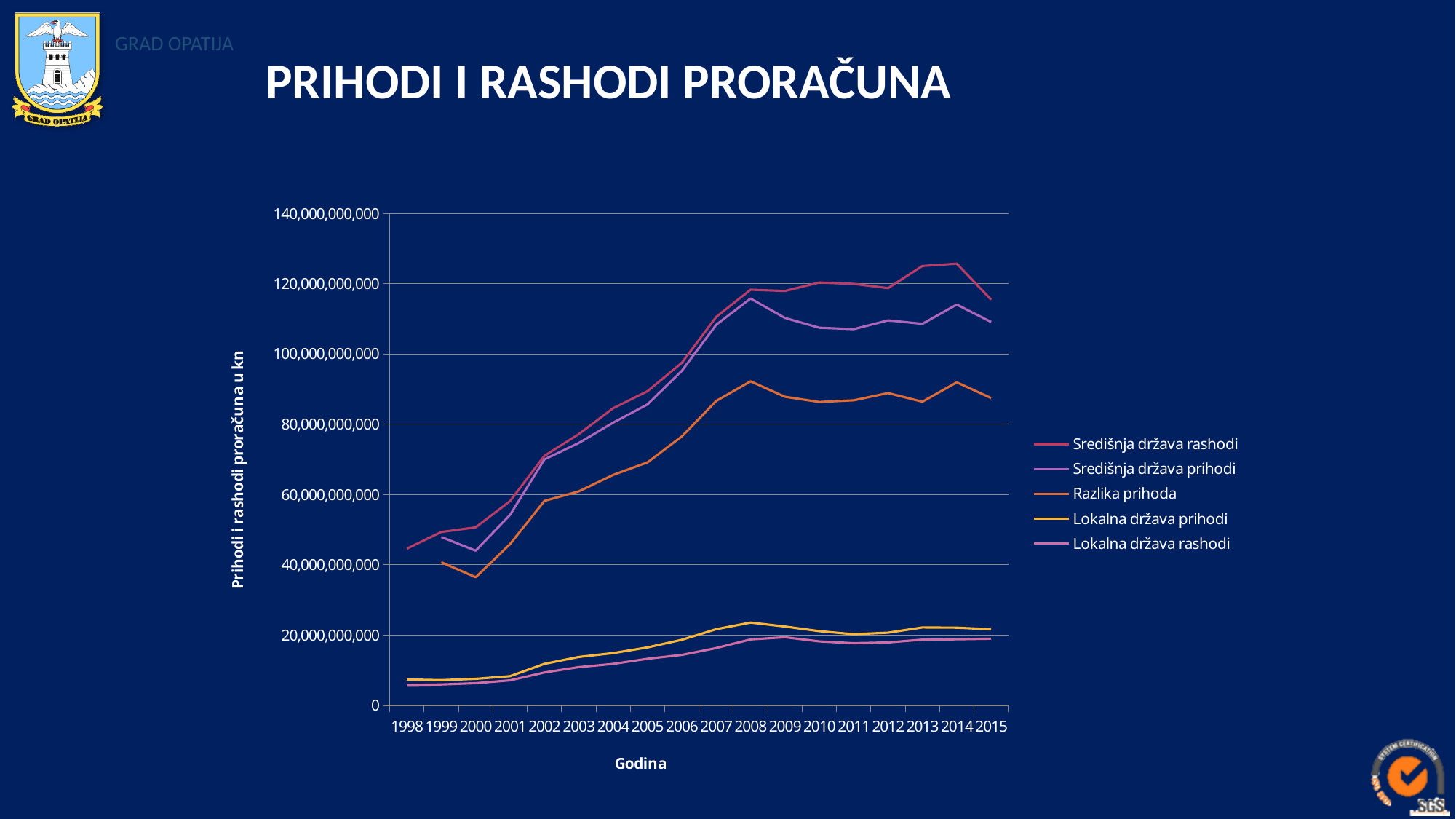
Is the value for Lokalna država prihodi in 2008 greater or less than 20,000,000,000? greater What is the title of the chart's x axis? Godina In which year is Razlika prihoda at its lowest? 2000 Is the value for Razlika prihoda in 2000 greater or less than 40,000,000,000? less Is the value for Središnja država rashodi in 2014 greater or less than 120,000,000,000? greater How many series does the legend list? 5 Does Razlika prihoda rise or fall overall from 2000 to 2008? rise What kind of chart is shown on the slide? line chart How many years are plotted along the x axis? 18 In which year does Središnja država rashodi reach its highest value? 2014 In 2015, which is larger: Središnja država rashodi or Središnja država prihodi? Središnja država rashodi